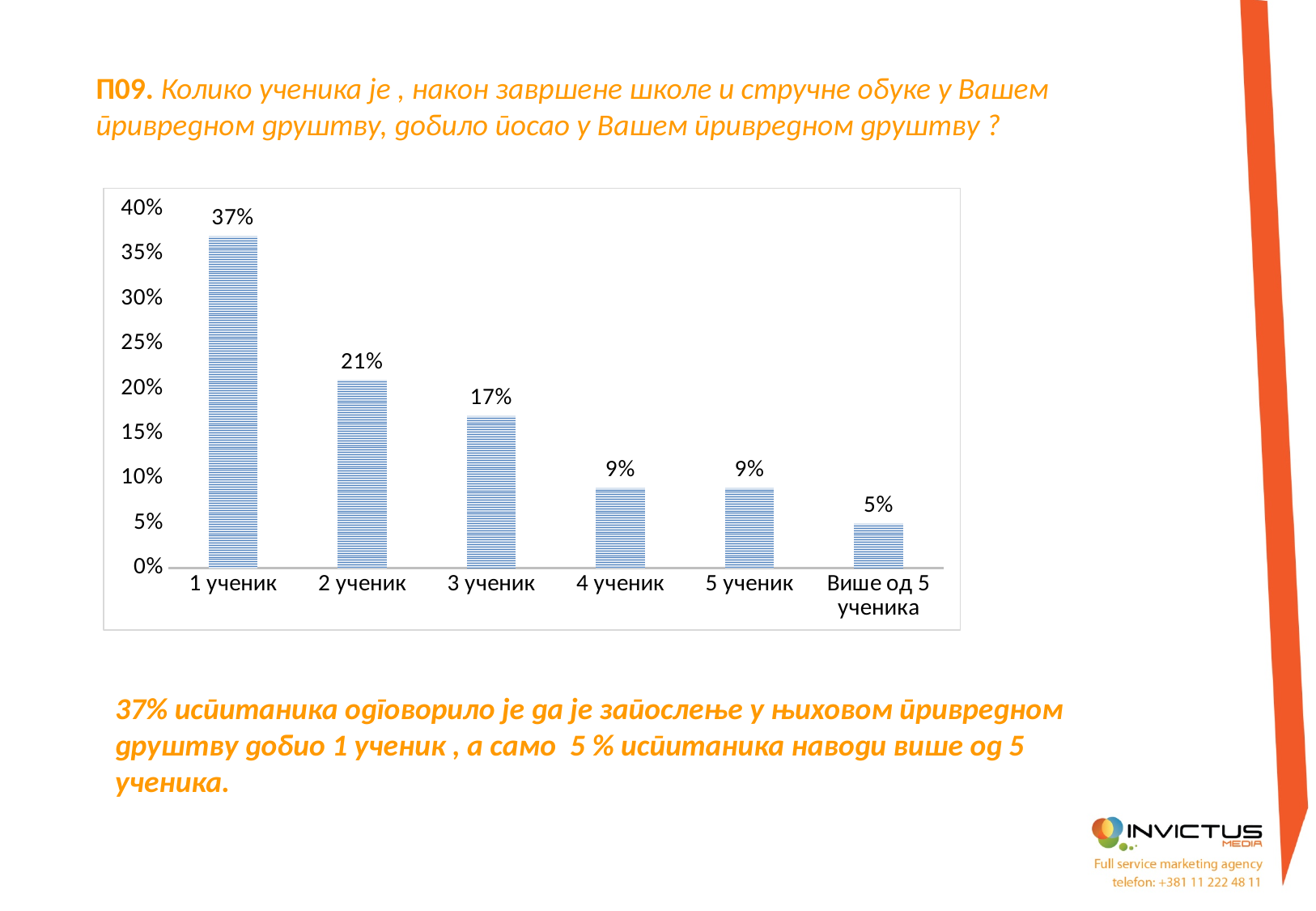
What is the difference between the values for "1 ученик" and "2 ученик"? 16% What is the value for "3 ученик"? 17% What is the value for "Више од 5 ученика"? 5% Which category has the lowest value? Више од 5 ученика What is the value for "1 ученик"? 37% Which is larger, the value for "2 ученик" or the value for "3 ученик"? 2 ученик How many categories are shown on the x axis? 6 Which category has the highest value? 1 ученик What kind of chart is shown on the slide? bar chart Is the value for "2 ученик" greater or less than 20%? greater Do the values generally rise or fall from left to right along the x axis? fall What is the highest tick value shown on the vertical axis? 40%